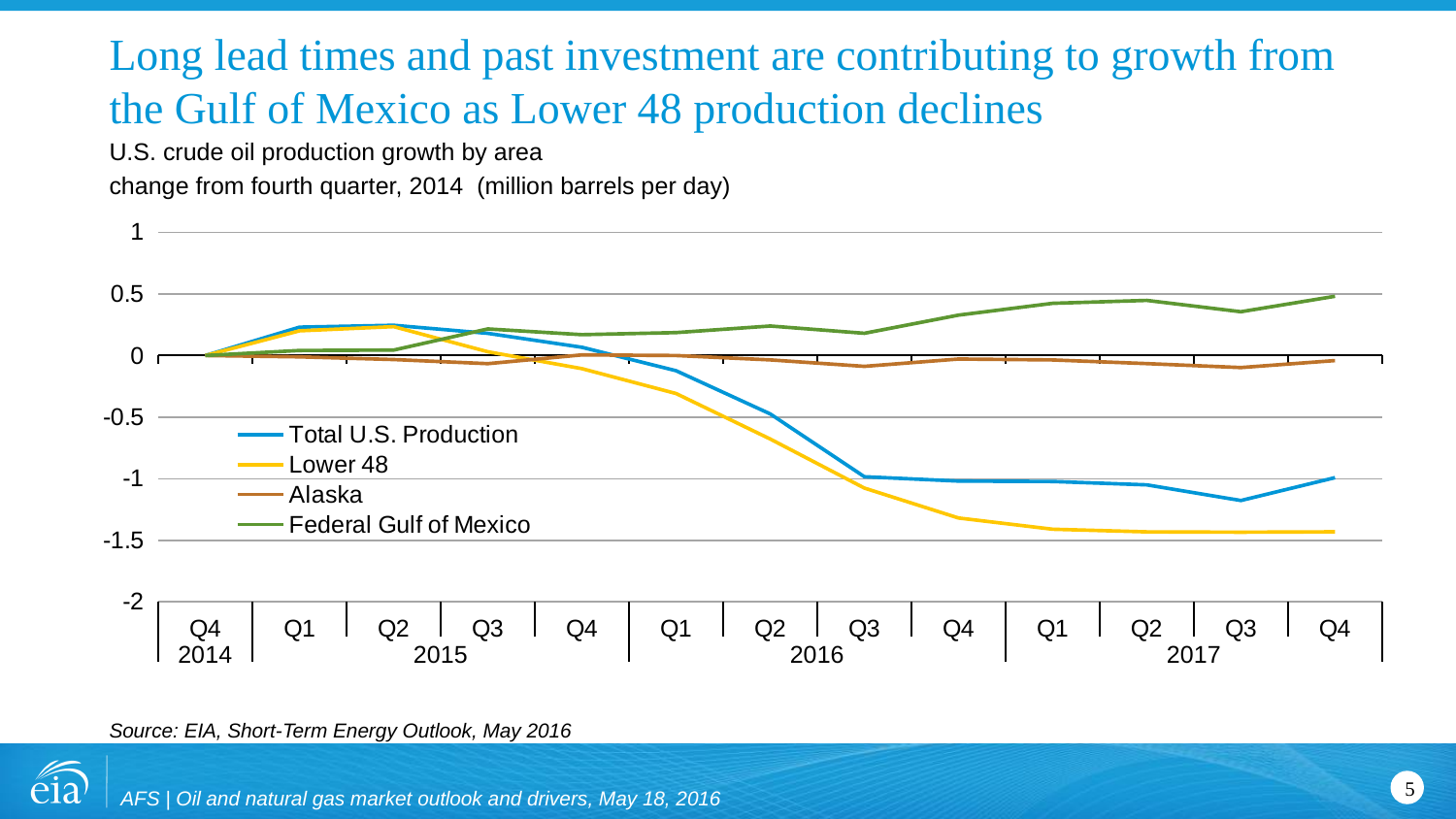
Is the value for Total U.S. Production in Q3 2016 greater or less than -0.5? less Is the value for Alaska in Q4 2017 greater or less than -0.5? greater Is the value for Lower 48 in Q4 2017 greater or less than -1? less What kind of chart is shown on the slide? line chart Which series has the lowest value in Q4 2017? Lower 48 Which series has the highest value in Q4 2017? Federal Gulf of Mexico What unit is given in the chart subtitle? million barrels per day Does the Lower 48 series generally rise or fall from Q4 2014 to Q4 2017? fall How many series does the legend list? 4 How many quarters are shown along the x axis? 13 What is the value for Total U.S. Production in Q4 2014? 0